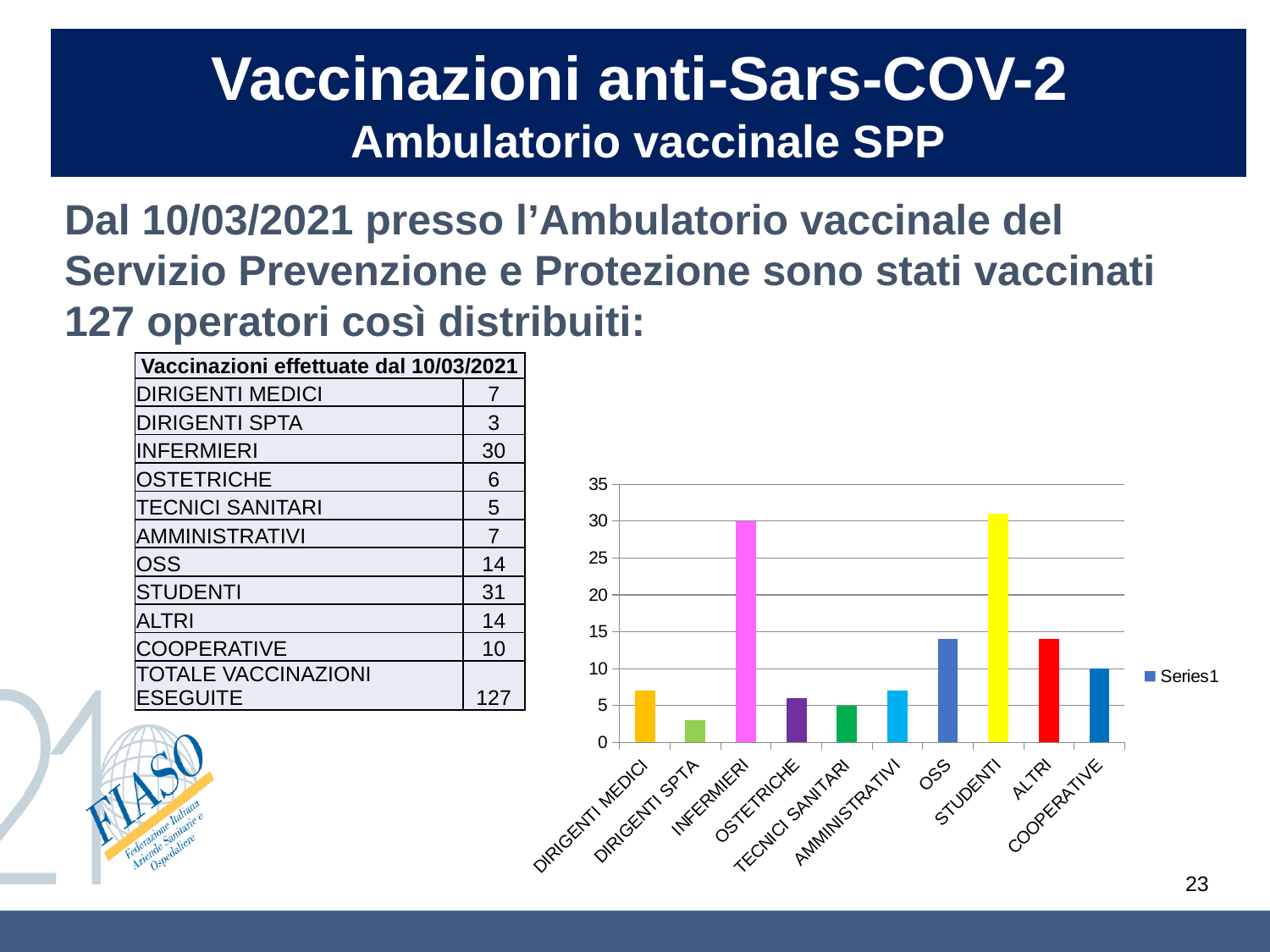
What is the difference between the values for STUDENTI and OSS? 17 Which is larger, the value for OSS or the value for COOPERATIVE? OSS What kind of chart is shown on the slide? bar chart How many categories are plotted on the x axis of the chart? 10 What is the value for INFERMIERI? 30 Is the value for INFERMIERI greater or less than 25? greater What is the value for COOPERATIVE? 10 What is the name of the series shown in the chart legend? Series1 What is the value for STUDENTI? 31 Which category has the lowest value? DIRIGENTI SPTA How many series does the chart legend list? 1 Which category has the highest value? STUDENTI